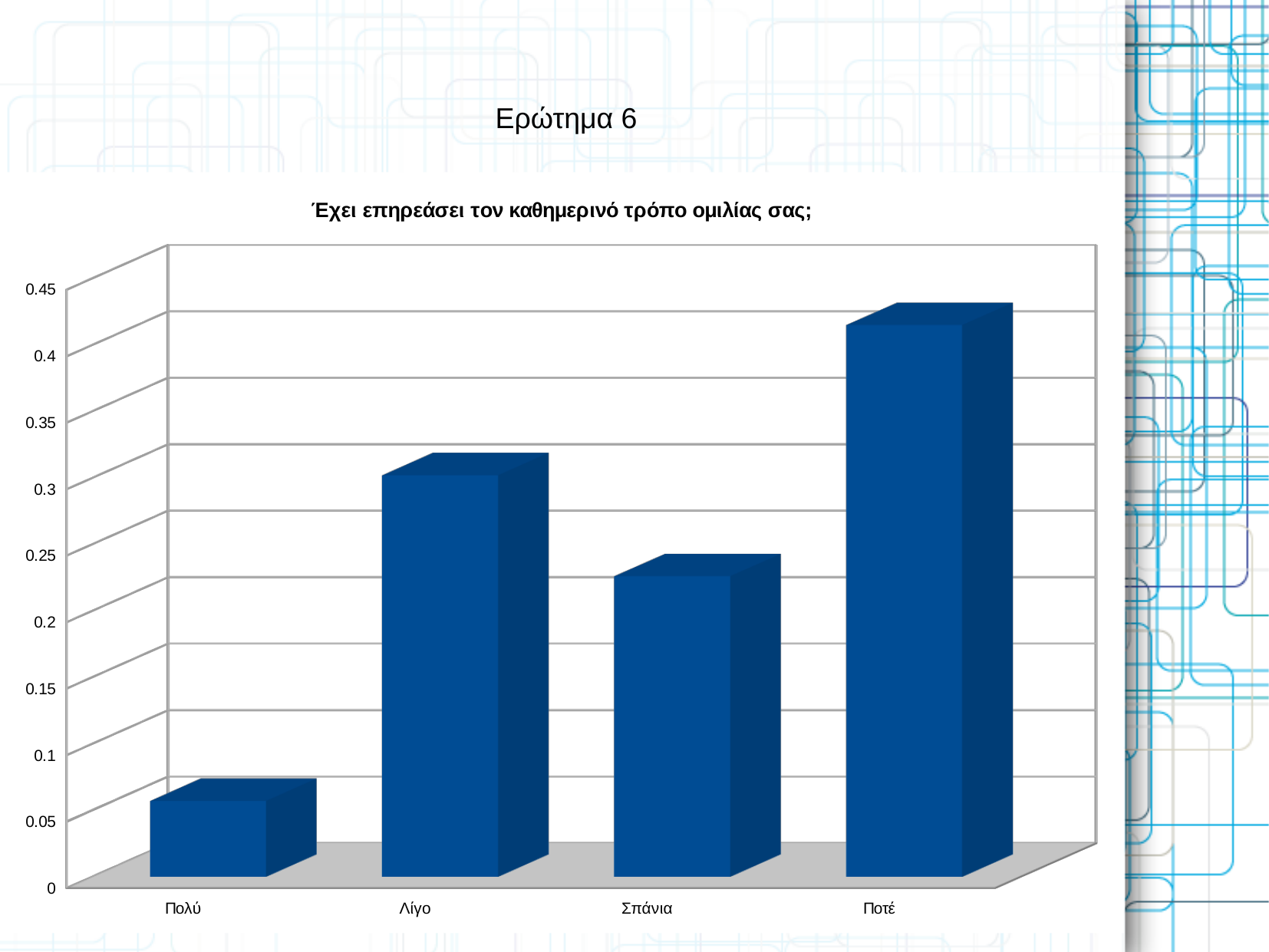
How many categories are shown on the x axis of the chart? 4 Is the value for Ποτέ greater or less than 0.35? greater Is the value for Πολύ greater or less than 0.15? less Is the value for Σπάνια greater or less than 0.3? less What kind of chart is shown on the slide? bar chart Which is larger, the value for Ποτέ or the value for Πολύ? Ποτέ Which category has the lowest value? Πολύ Which category has the highest value? Ποτέ What is the highest value shown on the vertical axis? 0.45 Which is larger, the value for Λίγο or the value for Σπάνια? Λίγο What is the title of the chart? Έχει επηρεάσει τον καθημερινό τρόπο ομιλίας σας;